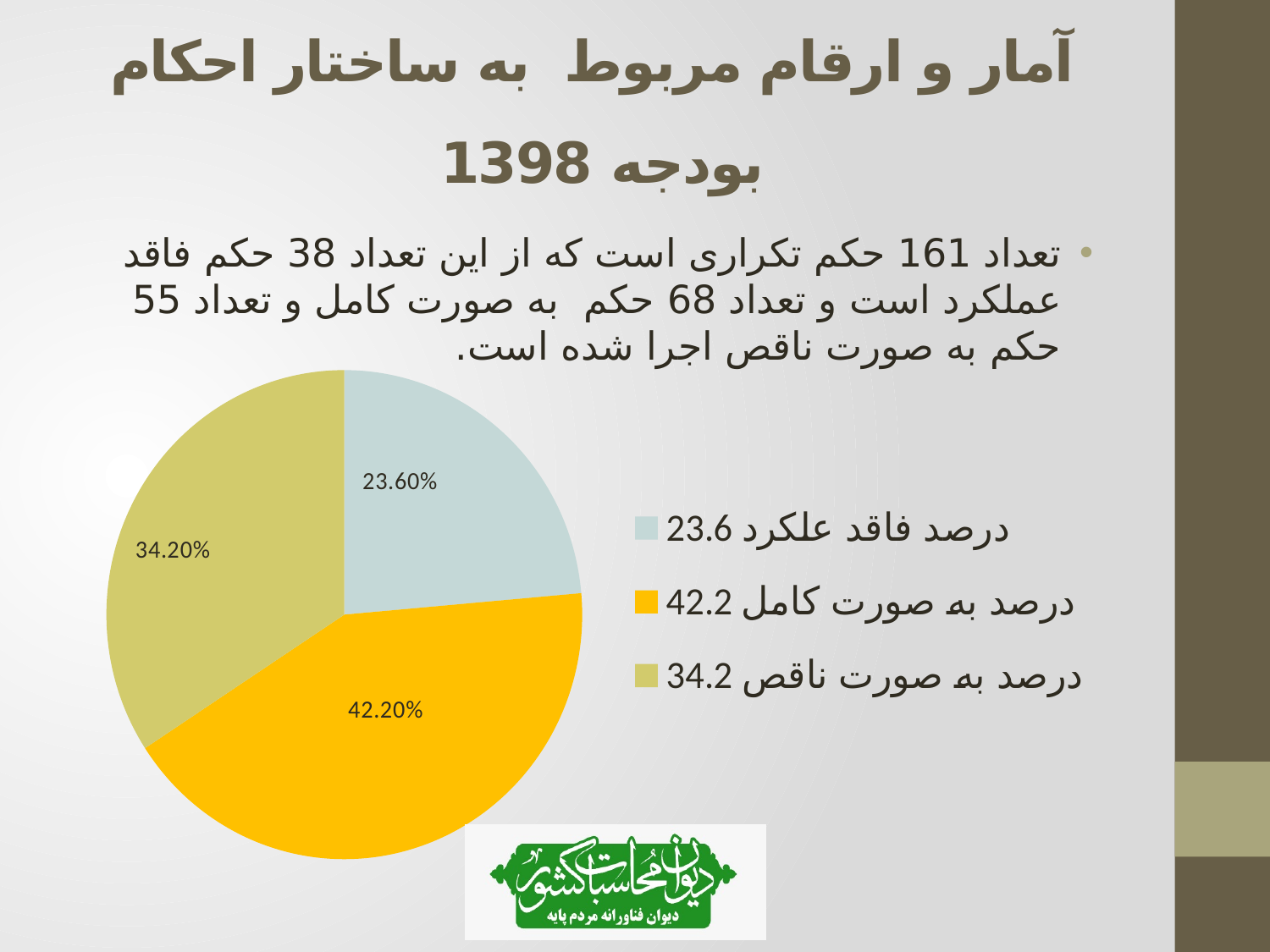
What colour is the slice representing 'درصد به صورت کامل 42.2'? yellow How many slices does the pie chart have? 3 How many entries does the legend of the pie chart list? 3 What percentage is shown for the slice labelled 'درصد به صورت کامل 42.2'? 42.20% What colour is the slice representing 'درصد فاقد علکرد 23.6'? light blue-grey What kind of chart is shown on the slide? pie chart What percentage is shown for the slice labelled 'درصد فاقد علکرد 23.6'? 23.60% Which is larger: the 'درصد به صورت ناقص' slice or the 'درصد فاقد علکرد' slice? درصد به صورت ناقص What is the difference in percentage points between the 'درصد به صورت کامل' slice and the 'درصد فاقد علکرد' slice? 18.60% Which slice of the pie chart is the smallest? درصد فاقد علکرد 23.6 What percentage is shown for the slice labelled 'درصد به صورت ناقص 34.2'? 34.20% Which slice of the pie chart is the largest? درصد به صورت کامل 42.2